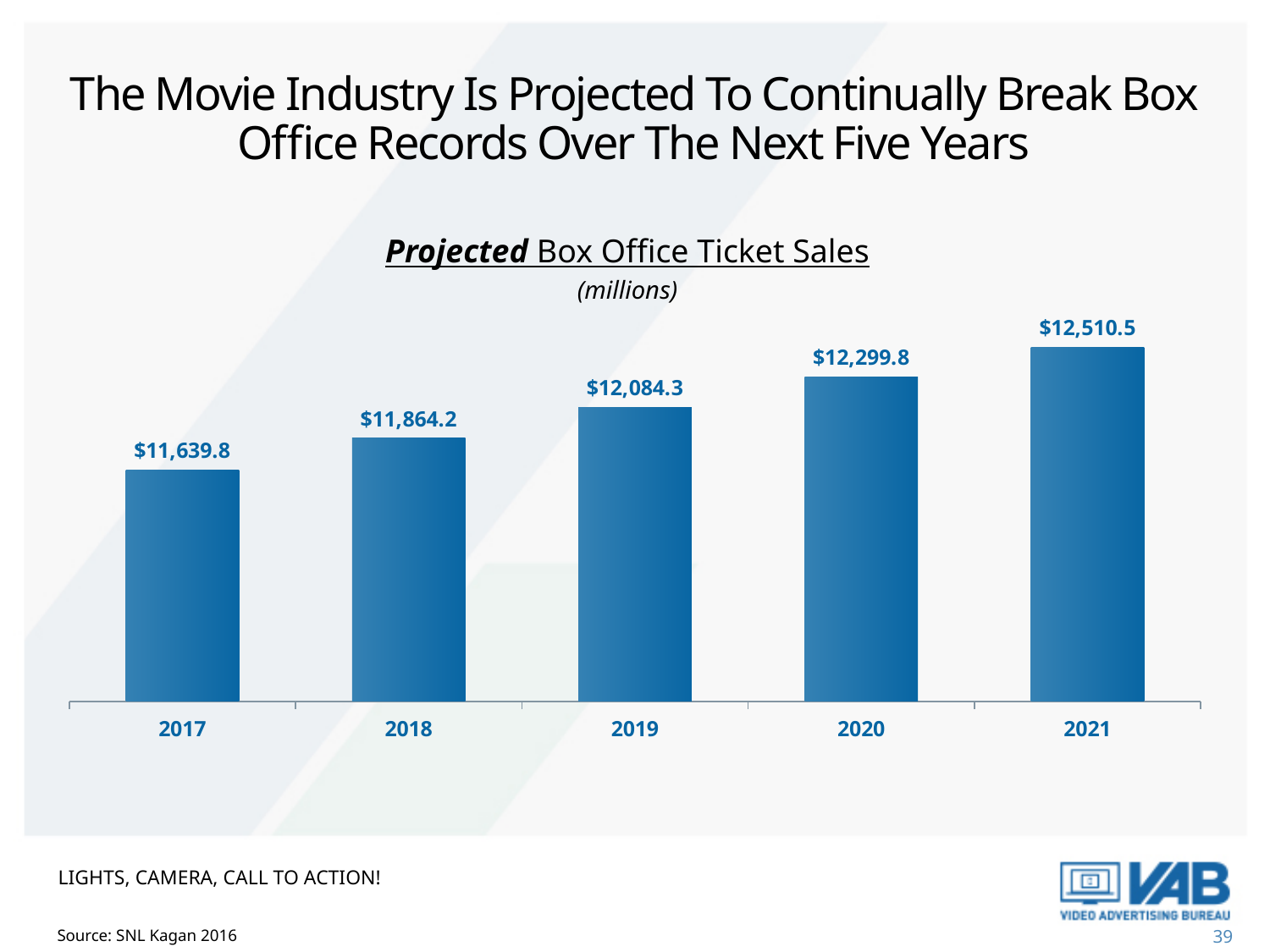
What is the projected box office ticket sales value for 2019? $12,084.3 Which year has the lowest projected box office ticket sales? 2017 How many years are shown in the chart? 5 What is the projected box office ticket sales value for 2017? $11,639.8 What is the difference between the projected box office ticket sales for 2021 and 2017? $870.7 What is the difference between the projected box office ticket sales for 2020 and 2019? $215.5 In what units are the values in the chart expressed? Millions Which year has the highest projected box office ticket sales? 2021 What kind of chart is shown on the slide? Bar chart Do the projected box office ticket sales rise or fall from 2017 to 2021? Rise Which year has larger projected box office ticket sales, 2018 or 2020? 2020 What is the projected box office ticket sales value for 2021? $12,510.5